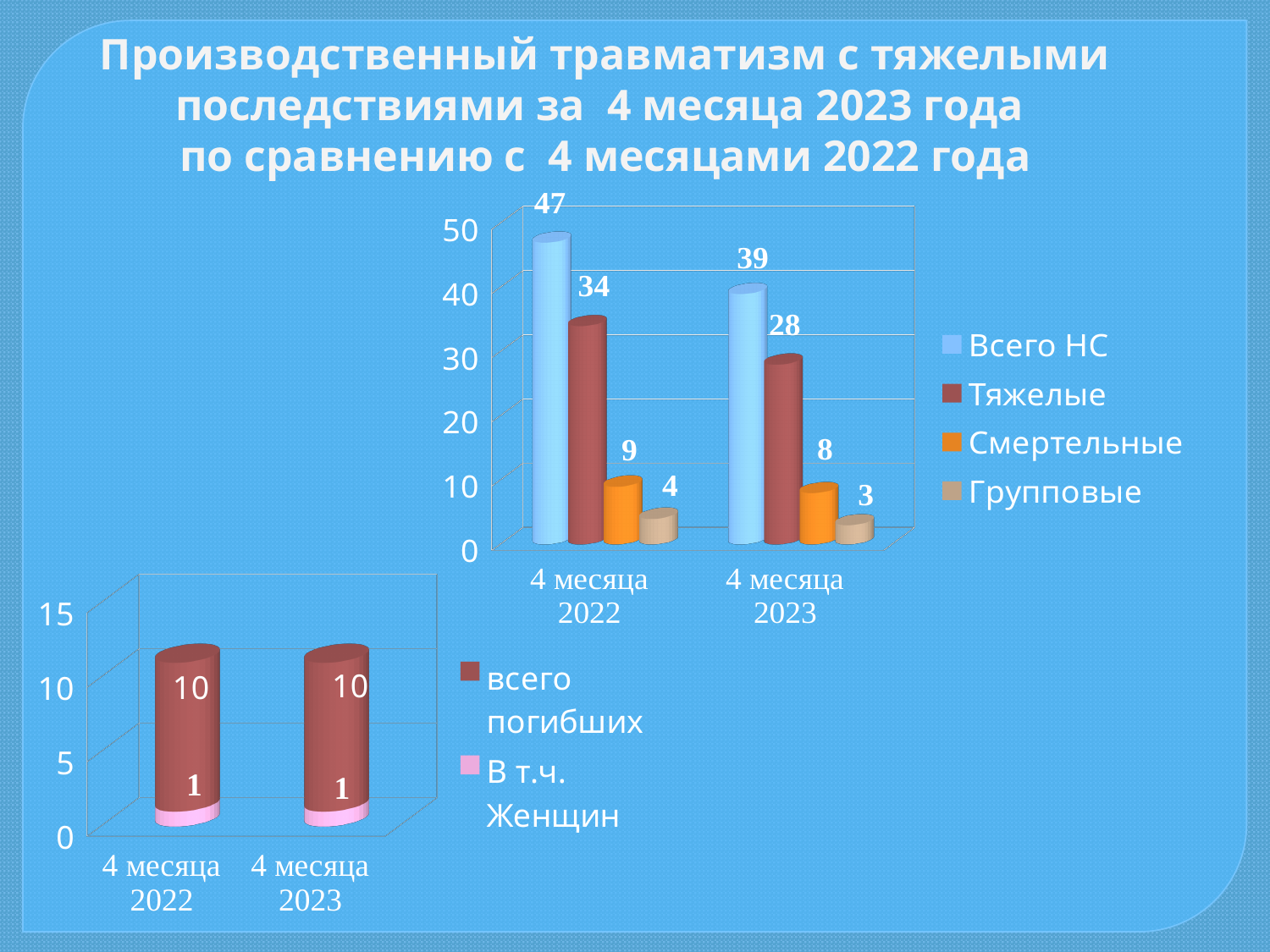
In the top-right chart, what is the value of Всего НС for 4 месяца 2022? 47 In the top-right chart, what is the value of Групповые for 4 месяца 2023? 3 In the top-right chart, does the value of Всего НС rise or fall from 4 месяца 2022 to 4 месяца 2023? fall In the bottom-left chart, what is the value of В т.ч. Женщин for 4 месяца 2022? 1 In the top-right chart, which is larger: Тяжелые for 4 месяца 2022 or Тяжелые for 4 месяца 2023? 4 месяца 2022 In the top-right chart, what is the value of Тяжелые for 4 месяца 2023? 28 In the top-right chart, by how much did Всего НС decrease from 4 месяца 2022 to 4 месяца 2023? 8 In the top-right chart, what is the value of Смертельные for 4 месяца 2022? 9 How many series does the legend of the top-right chart list? 4 What kind of chart is the bottom-left chart? bar chart In the bottom-left chart, what is the value of всего погибших for 4 месяца 2023? 10 In the top-right chart, which series has the lowest value for 4 месяца 2022? Групповые